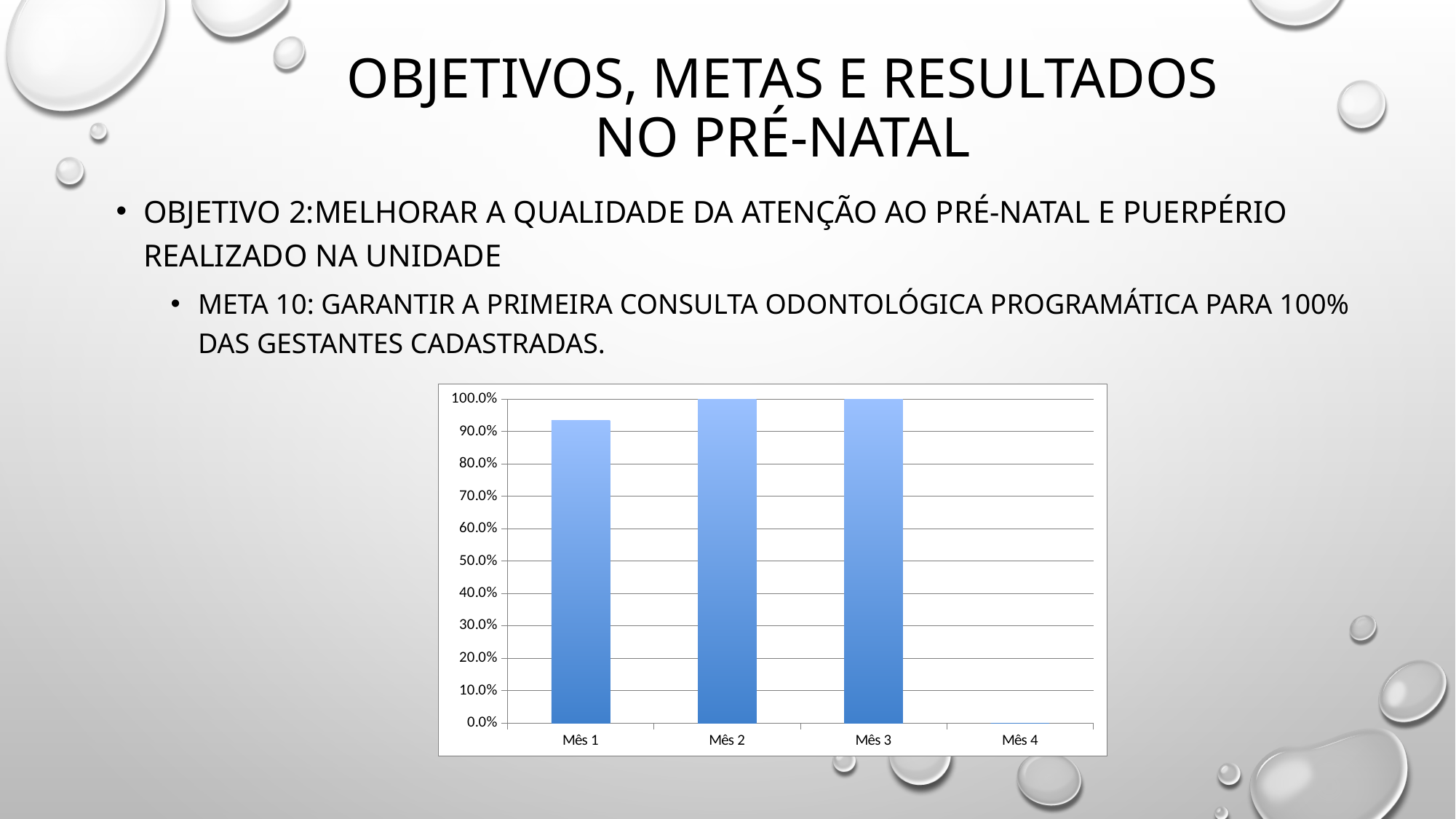
How many bars are visible in the chart? 3 Which is larger, the value for Mês 1 or the value for Mês 2? Mês 2 What is the value for Mês 2 in the chart? 100.0% What is the value for Mês 3 in the chart? 100.0% What is the label of the last category on the x axis of the chart? Mês 4 What is the highest tick label on the y axis of the chart? 100.0% Is the value for Mês 1 greater or less than 100.0%? less What kind of chart is shown on the slide? bar chart How many categories are labelled on the x axis of the chart? 4 Is the value for Mês 1 greater or less than 90.0%? greater Among Mês 1, Mês 2 and Mês 3, which has the lowest value? Mês 1 Do the values rise or fall from Mês 1 to Mês 3? rise